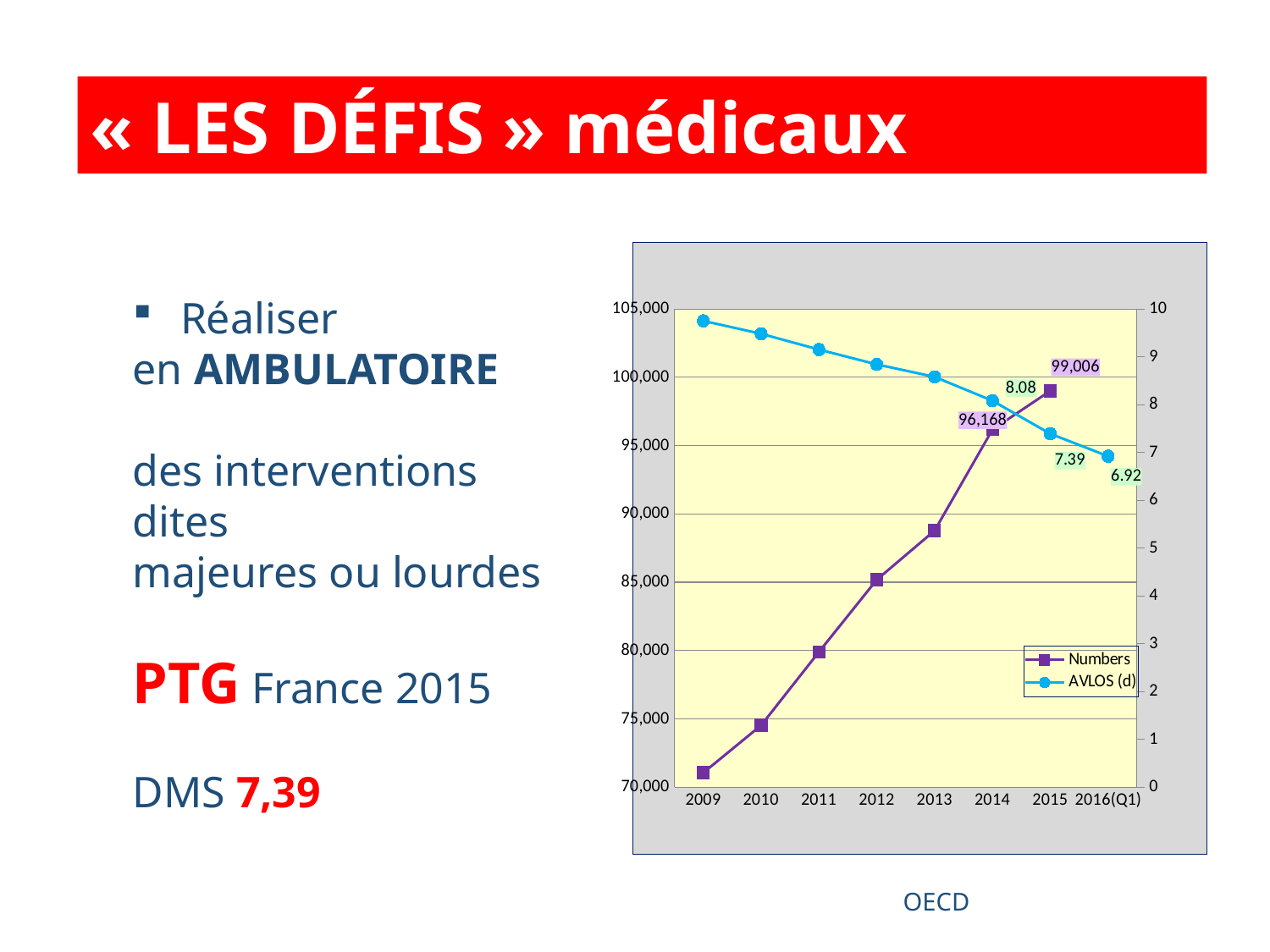
Does the AVLOS (d) series rise or fall from 2009 to 2016(Q1)? fall What is the AVLOS (d) value in 2014? 8.08 By how much did the Numbers series increase from 2014 to 2015? 2,838 Is the value of the Numbers series in 2009 greater or less than 75,000? less How many series does the chart legend list? 2 What is the value of the Numbers series in 2015? 99,006 What are the two series named in the chart legend? Numbers and AVLOS (d) What is the difference between the AVLOS (d) values in 2014 and 2015? 0.69 What kind of chart is shown on the slide? line chart What is the value of the Numbers series in 2014? 96,168 What is the AVLOS (d) value in 2016(Q1)? 6.92 How many year categories are shown on the x axis? 8